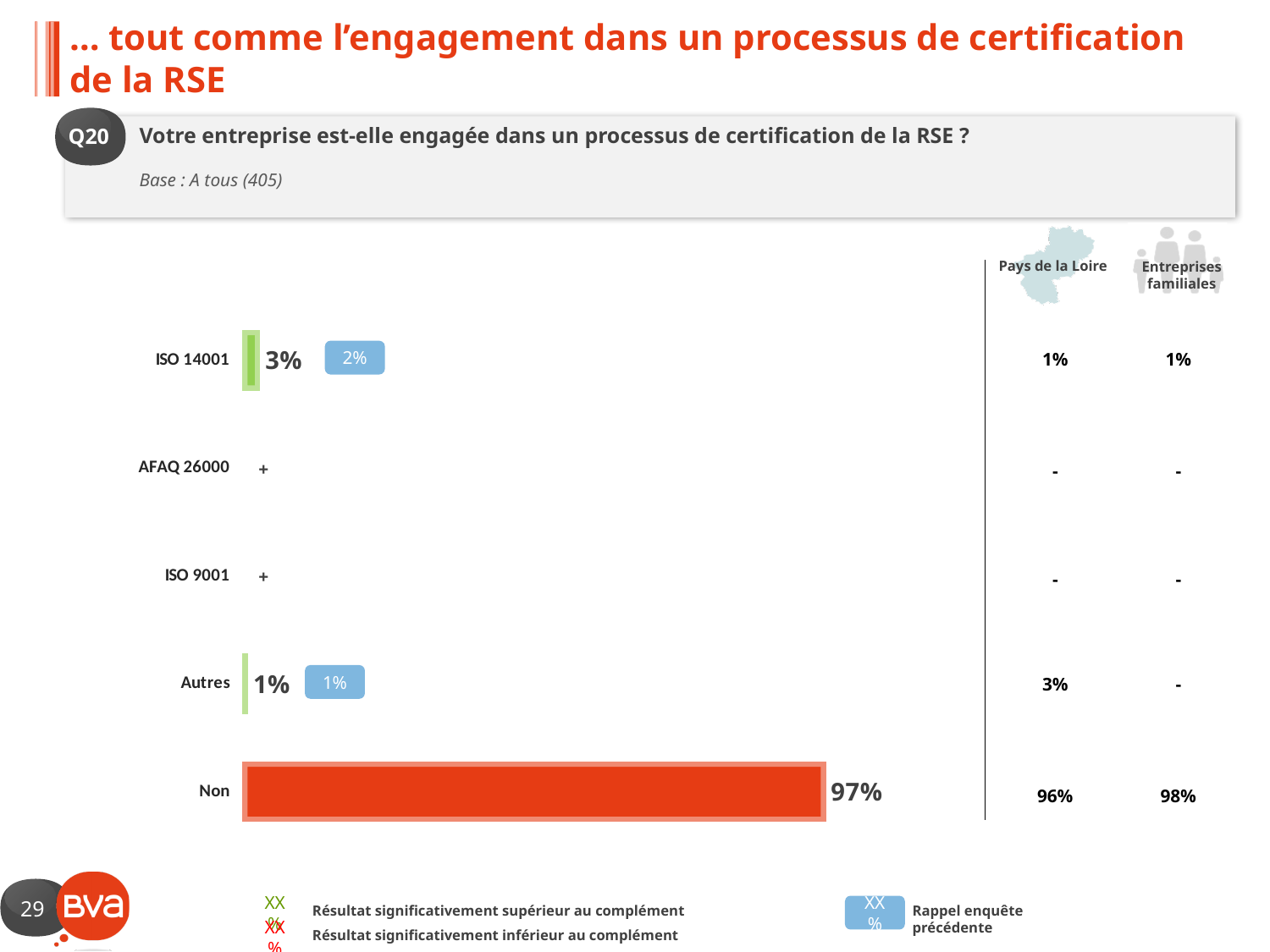
What is the value for Non in the bar chart? 97% What is the base (number of respondents) stated for question Q20? 405 What kind of chart is shown on the slide? Bar chart What is the difference between the values for Non and ISO 14001? 94% Which is larger, the value for ISO 14001 or the value for Autres? ISO 14001 What is the value for ISO 14001 in the bar chart? 3% What is the Pays de la Loire value for Non in the right-hand column? 96% What is the Entreprises familiales value for Non in the right-hand column? 98% Which category has the highest value in the bar chart? Non How many categories are shown in the bar chart? 5 What is the value for Autres in the bar chart? 1% What was the previous survey value (blue box) for ISO 14001? 2%